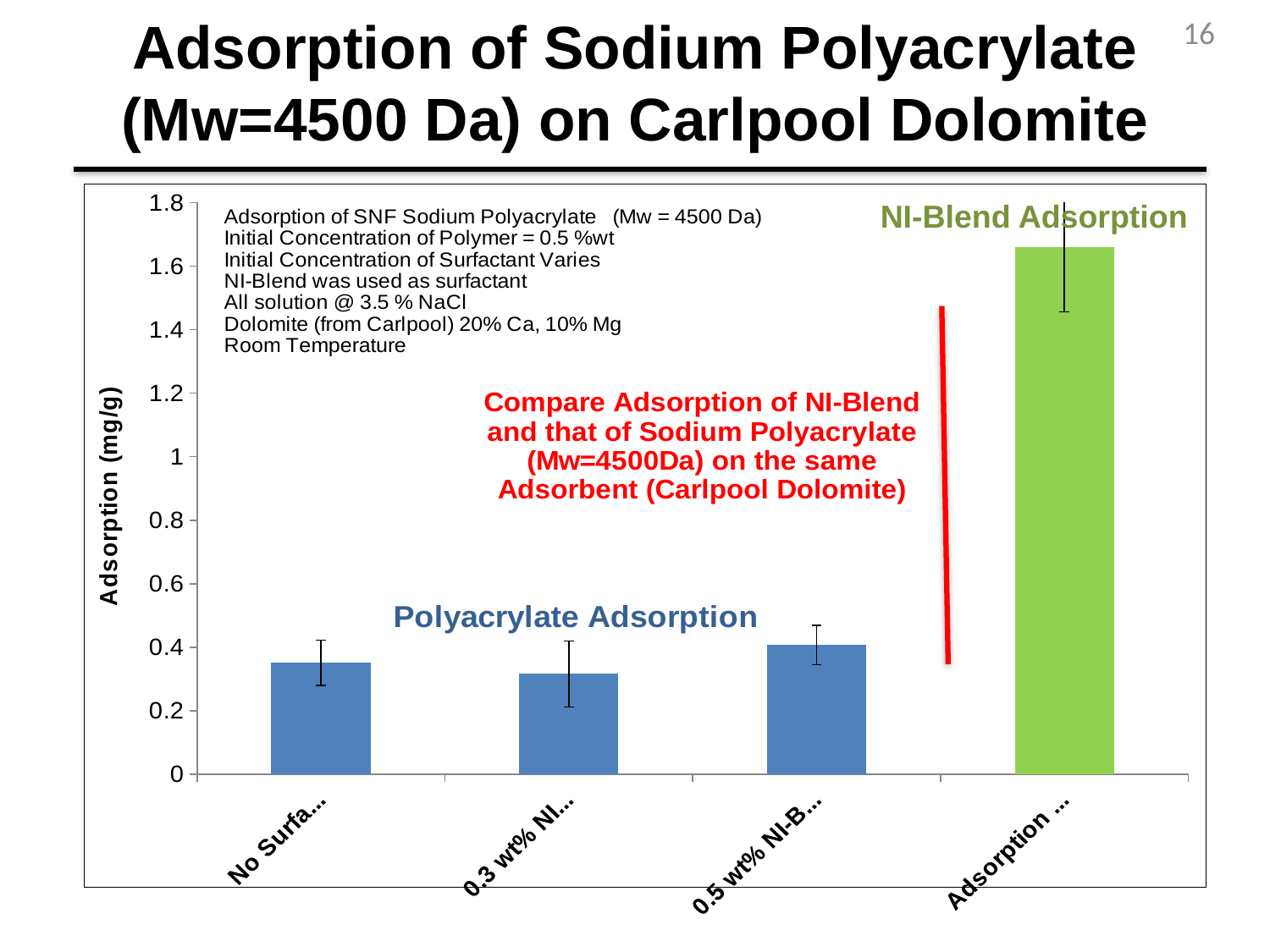
Is the value of the second blue bar (0.3 wt% NI...) greater or less than 0.4 mg/g? less Which is larger, the third blue bar (0.5 wt% NI-B...) or the second blue bar (0.3 wt% NI...)? the third blue bar (0.5 wt% NI-B...) Which is larger, the green NI-Blend Adsorption bar or the first blue bar? the green NI-Blend Adsorption bar How many blue bars are in the chart? 3 Is the value of the first (leftmost) blue bar greater or less than 0.4 mg/g? less Is the value of the green NI-Blend Adsorption bar greater or less than 1.4 mg/g? greater What is the label of the y-axis? Adsorption (mg/g) What colour is the tallest bar in the chart? green Which bar has the highest adsorption value? the green NI-Blend Adsorption bar (fourth bar) What kind of chart is shown on the slide? bar chart How many bars are plotted in the chart? 4